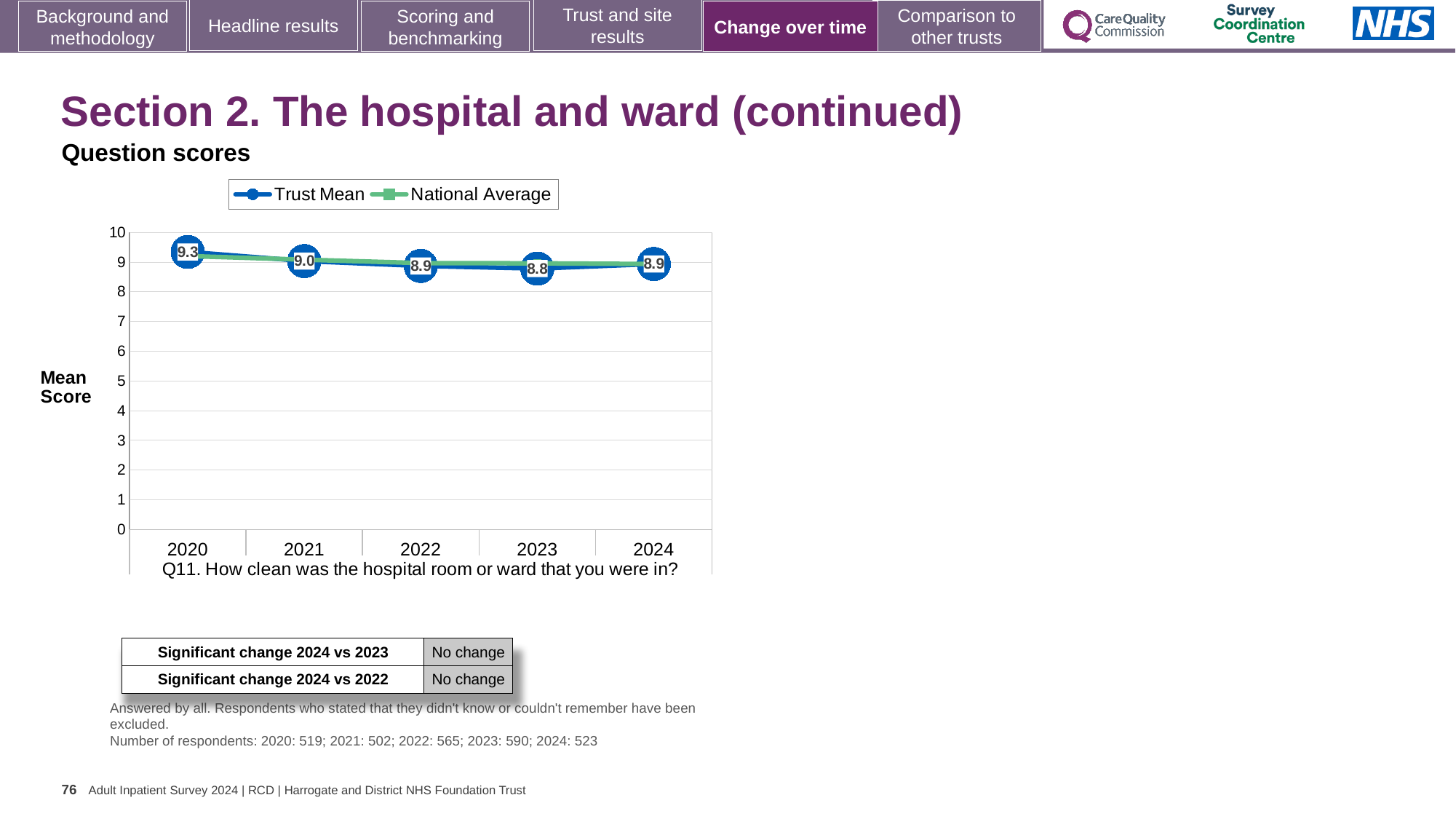
What is the Trust Mean value for 2024? 8.9 How many series does the chart legend list? 2 In which year is the Trust Mean highest? 2020 In which year is the Trust Mean lowest? 2023 What is the difference between the Trust Mean in 2020 and in 2023? 0.5 How many years are shown on the x axis of the chart? 5 Which survey question does the chart show scores for? Q11. How clean was the hospital room or ward that you were in? What is the Trust Mean value for 2023? 8.8 Does the Trust Mean rise or fall from 2020 to 2023? Fall What kind of chart is shown on the slide? Line chart What is the Trust Mean value for 2020? 9.3 Which year has the larger Trust Mean, 2021 or 2022? 2021